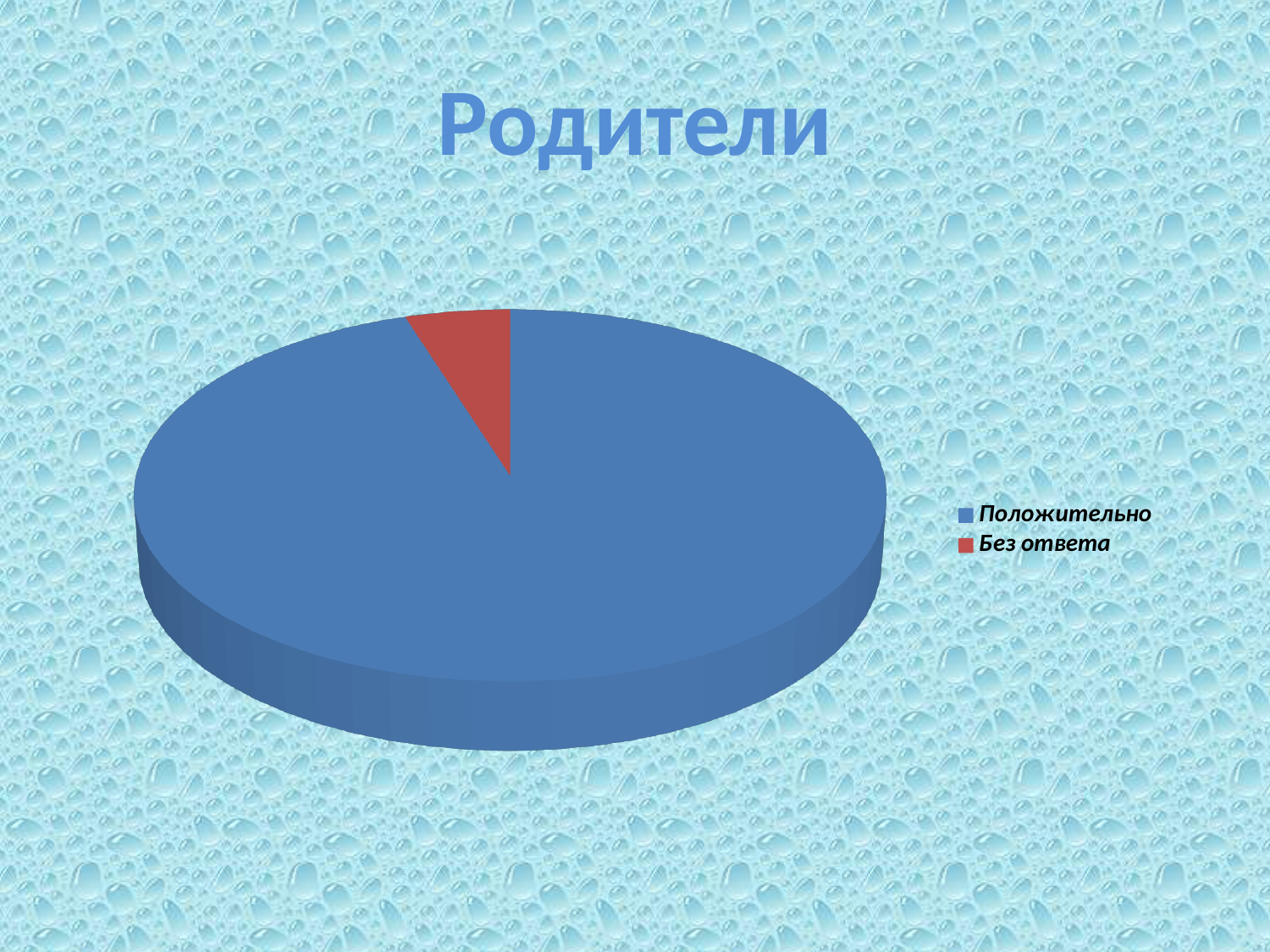
How many slices does the pie chart have? 2 What kind of chart is shown on the slide? Pie chart Which category has the largest slice of the pie? Положительно Which category has the smallest slice of the pie? Без ответа How many entries does the legend list? 2 Which is larger, the slice for Положительно or the slice for Без ответа? Положительно What is the title of the chart on the slide? Родители What colour is the slice for Без ответа? Red